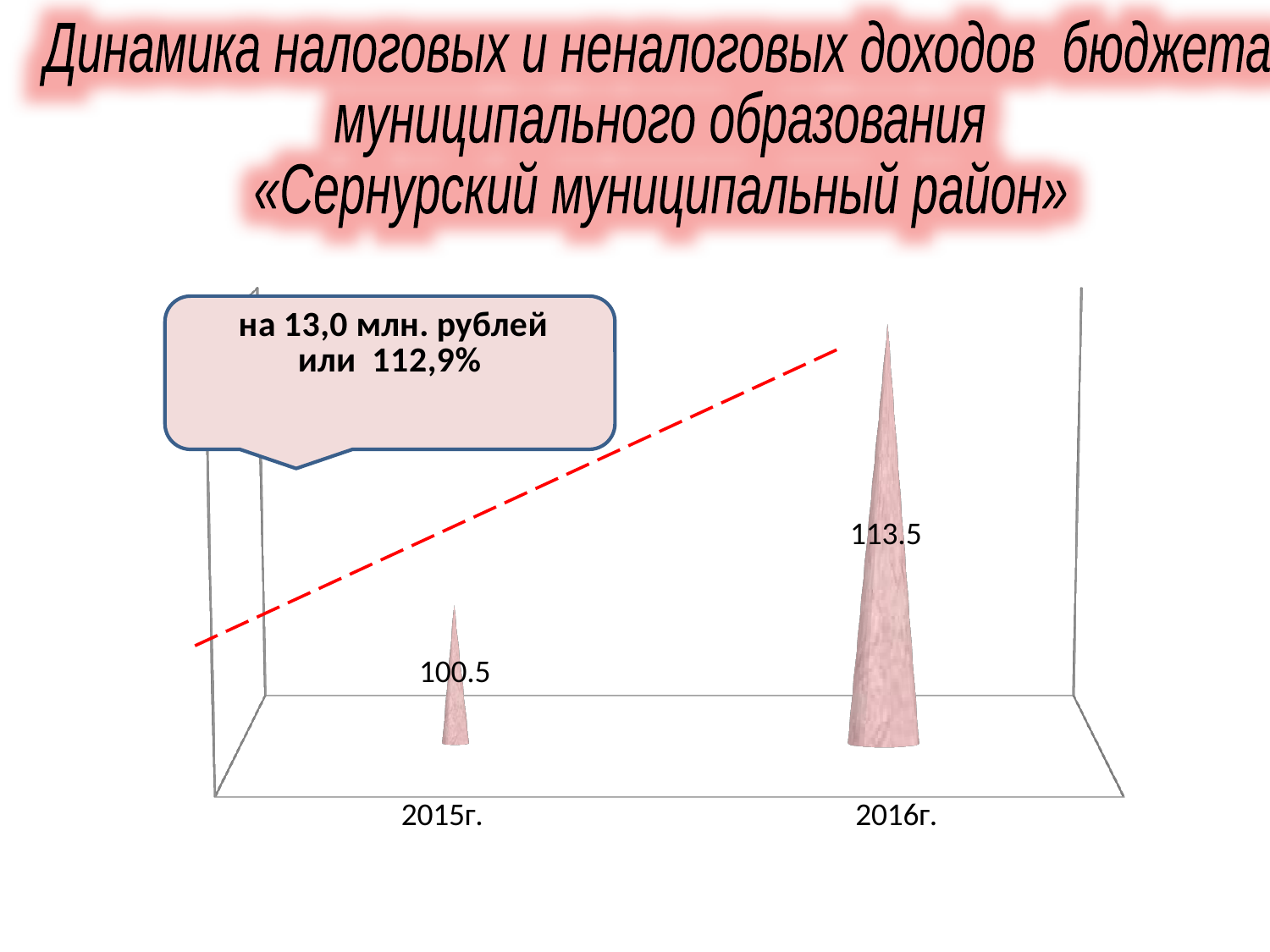
How many categories are shown on the chart? 2 Which year has the highest value? 2016г. What is the difference between the values for 2016г. and 2015г.? 13.0 What is the value for 2016г.? 113.5 According to the callout on the slide, what percentage growth is indicated? 112,9% What is the value for 2015г.? 100.5 What kind of chart is shown on the slide? Bar chart According to the callout on the slide, by how many million rubles did the revenue grow? 13,0 млн. рублей Which is larger, the value for 2015г. or the value for 2016г.? 2016г. Which year has the lowest value? 2015г. Do the values rise or fall from 2015г. to 2016г.? Rise